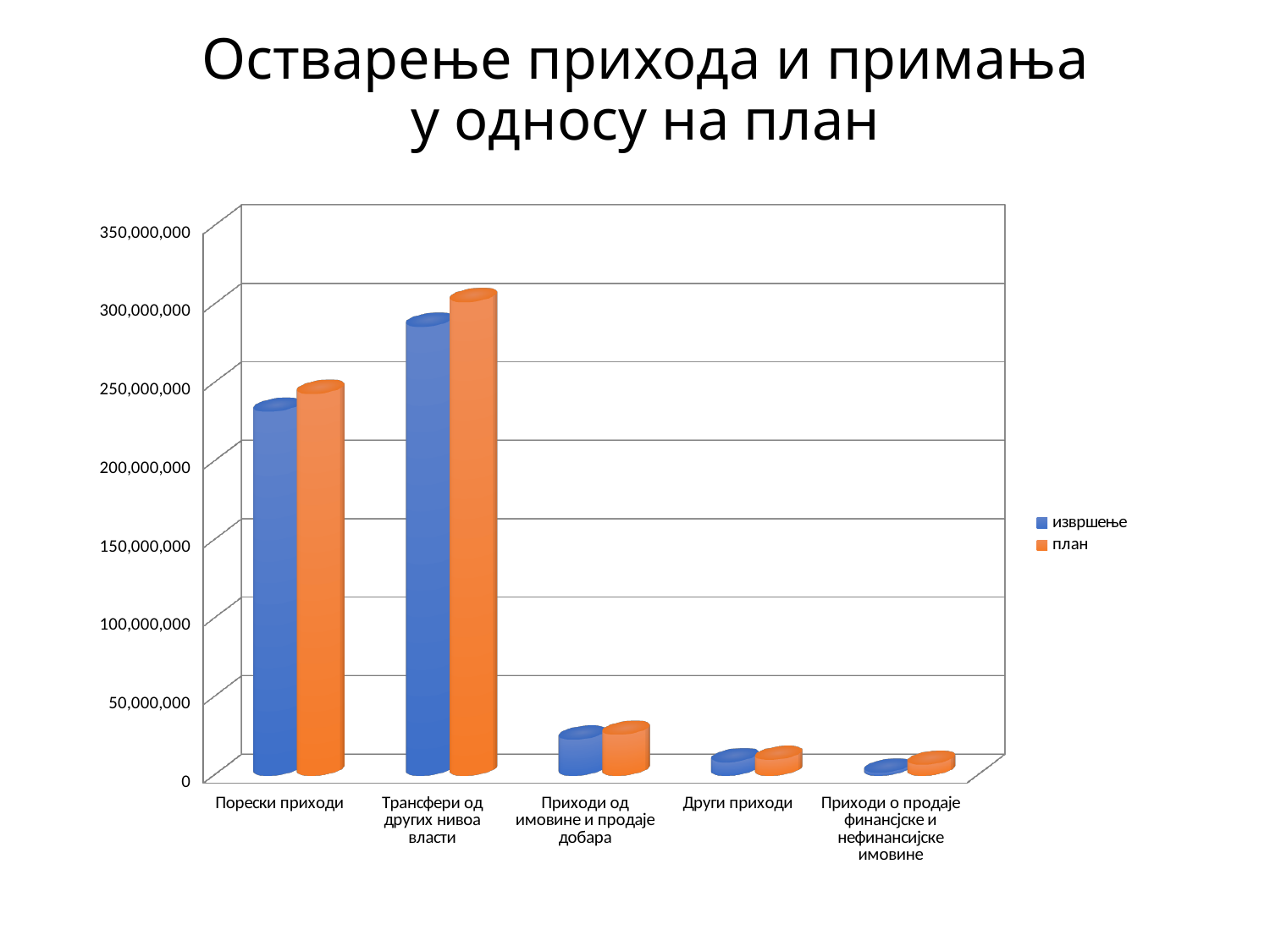
Is the извршење value for Порески приходи greater or less than 200,000,000? greater How many categories are shown on the x axis? 5 For Трансфери од других нивоа власти, which is larger: извршење or план? план Which colour represents the план series in the legend? orange Which category has the lowest value for the извршење series? Приходи о продаје финансјске и нефинансијске имовине Is the план value for Приходи од имовине и продаје добара greater or less than 50,000,000? less What kind of chart is shown on the slide? bar chart What is the title of the chart on the slide? Остварење прихода и примања у односу на план Which category has the highest value for the план series? Трансфери од других нивоа власти How many series does the legend list? 2 Is the извршење value for Трансфери од других нивоа власти greater or less than 250,000,000? greater For Порески приходи, which is larger: извршење or план? план